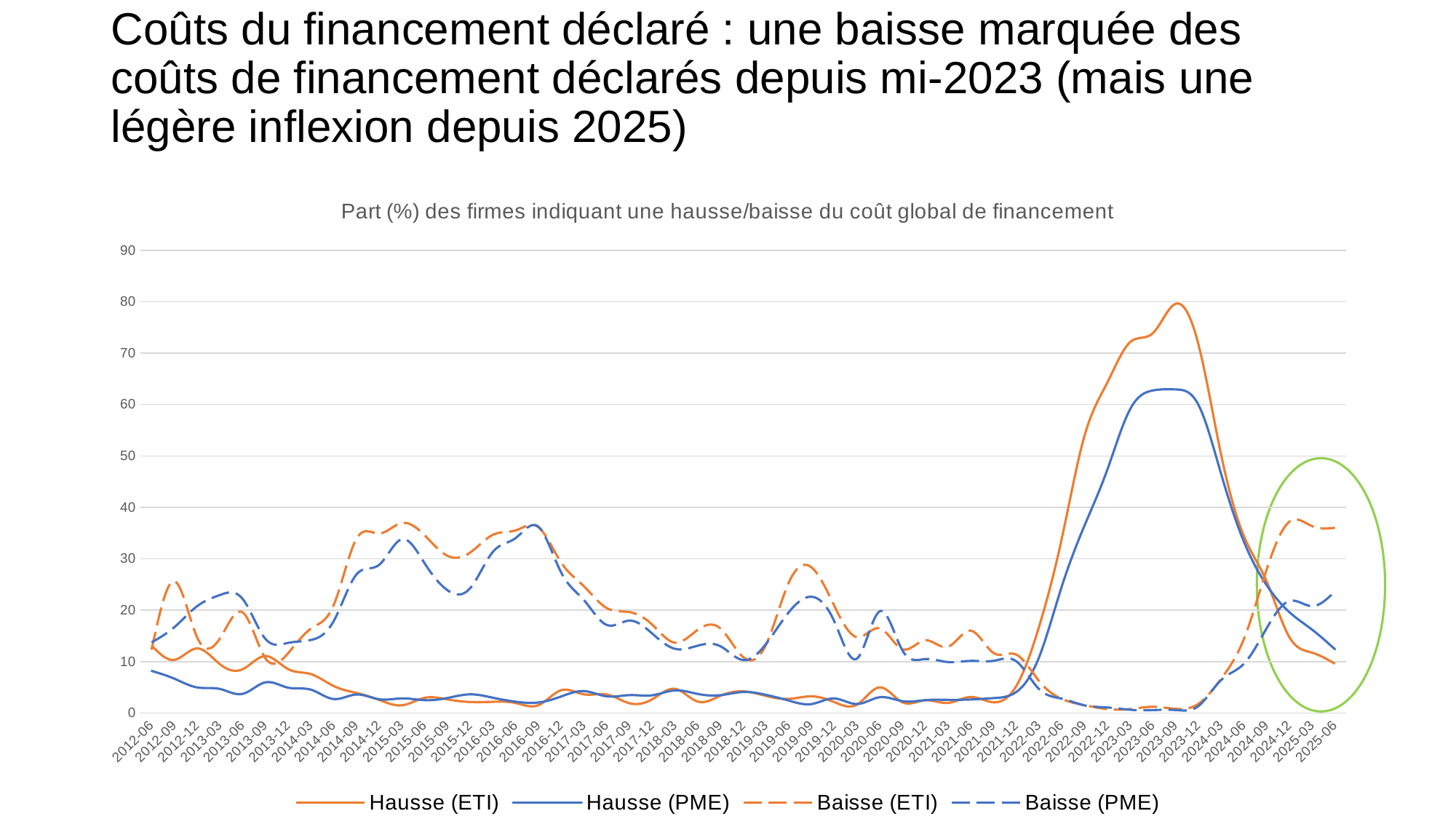
What are the series names listed in the legend? Hausse (ETI), Hausse (PME), Baisse (ETI), Baisse (PME) Is the value of Baisse (ETI) at 2025-06 greater or less than 30? greater What kind of chart is shown on the slide? line chart Which series reaches the highest value anywhere on the chart? Hausse (ETI) Does the Hausse (ETI) series rise or fall between 2023-09 and 2025-06? fall What is the title of the chart? Part (%) des firmes indiquant une hausse/baisse du coût global de financement Is the peak value of Hausse (PME) around 2023-06 greater or less than 50? greater At 2023-09, which is larger: Hausse (ETI) or Hausse (PME)? Hausse (ETI) Is the value of Hausse (ETI) at 2025-06 greater or less than 20? less At 2025-06, which is larger: Baisse (ETI) or Hausse (ETI)? Baisse (ETI) How many series does the legend list? 4